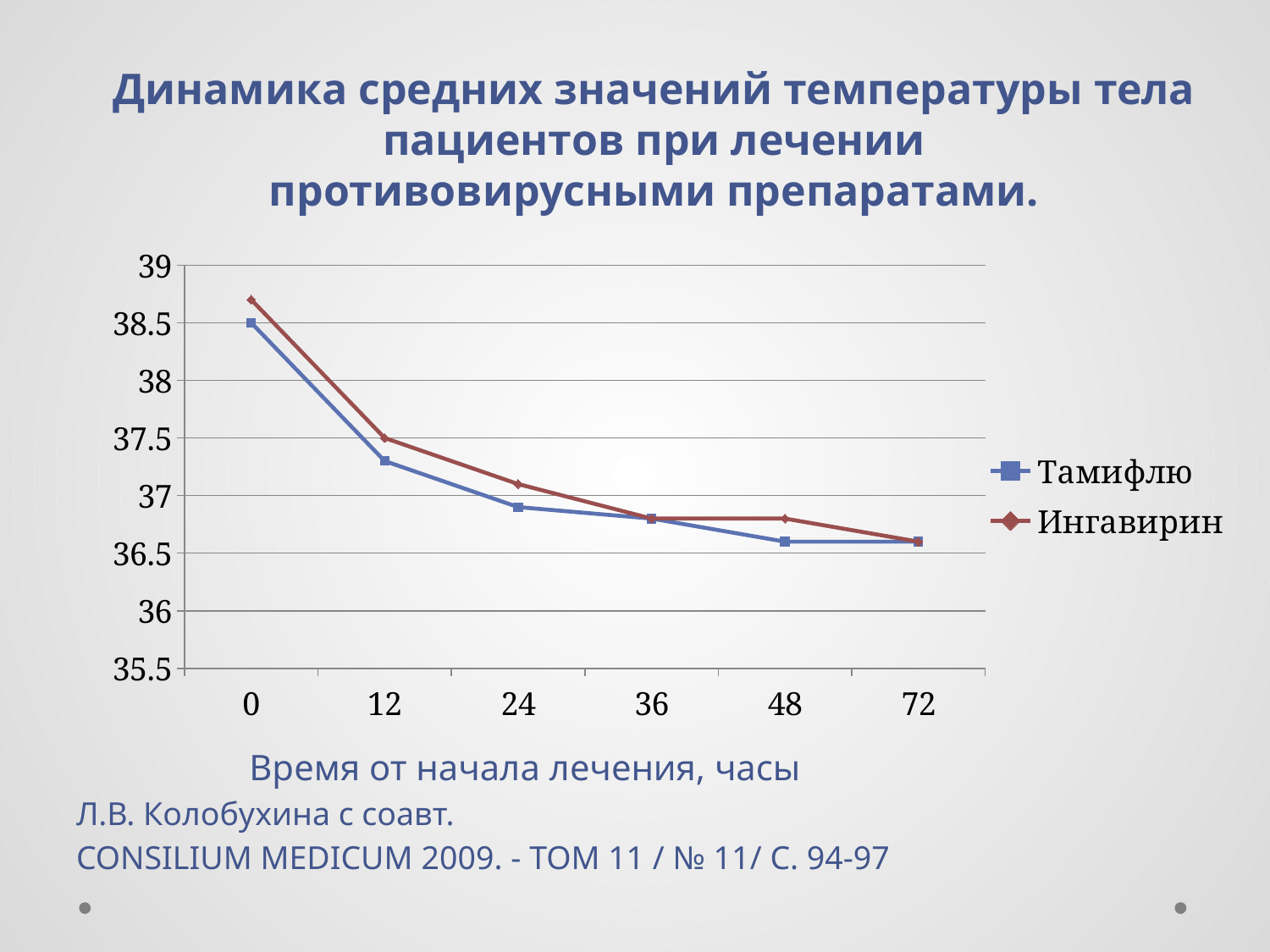
Which two series are listed in the legend? Тамифлю and Ингавирин What is the title of the x axis? Время от начала лечения, часы Is the value for Ингавирин at 0 hours greater or less than 38.5? greater How many series does the legend list? 2 Do the temperature values for Тамифлю rise or fall as time from the start of treatment increases? fall How many time points are plotted along the x axis? 6 At which time point is the value for Тамифлю highest? 0 At 0 hours, which series has the higher value, Тамифлю or Ингавирин? Ингавирин What kind of chart is shown on the slide? line chart Is the value for Тамифлю at 12 hours greater or less than 37.5? less At which time point is the value for Ингавирин highest? 0 At 12 hours, which series has the higher value, Тамифлю or Ингавирин? Ингавирин